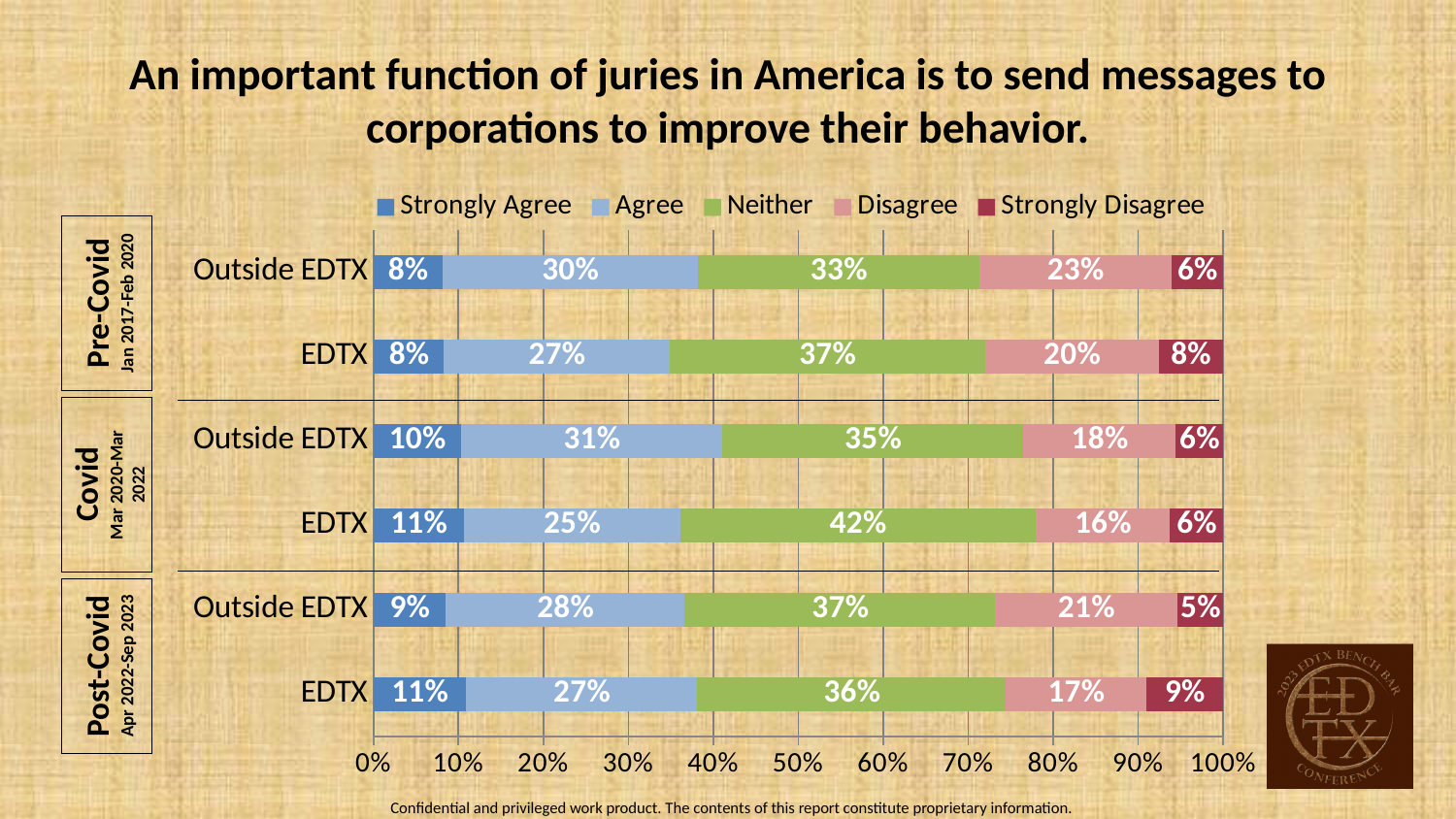
Which bar has the highest Neither percentage? Covid EDTX (42%) What is the Agree value for the Covid Outside EDTX bar? 31% What is the Strongly Disagree value for the Post-Covid EDTX bar? 9% What is the combined Strongly Agree and Agree percentage for the Post-Covid EDTX bar? 38% What kind of chart is shown on the slide? Stacked bar chart What is the difference between the Disagree values for Pre-Covid Outside EDTX and Pre-Covid EDTX? 3% What percentage of Pre-Covid Outside EDTX respondents answered Neither? 33% Which has a larger Strongly Agree value, Covid EDTX or Pre-Covid EDTX? Covid EDTX Which bar has the lowest Strongly Disagree percentage? Post-Covid Outside EDTX (5%) How many bars are plotted in the chart? 6 How many series does the legend list? 5 Which legend entry is shown in green? Neither